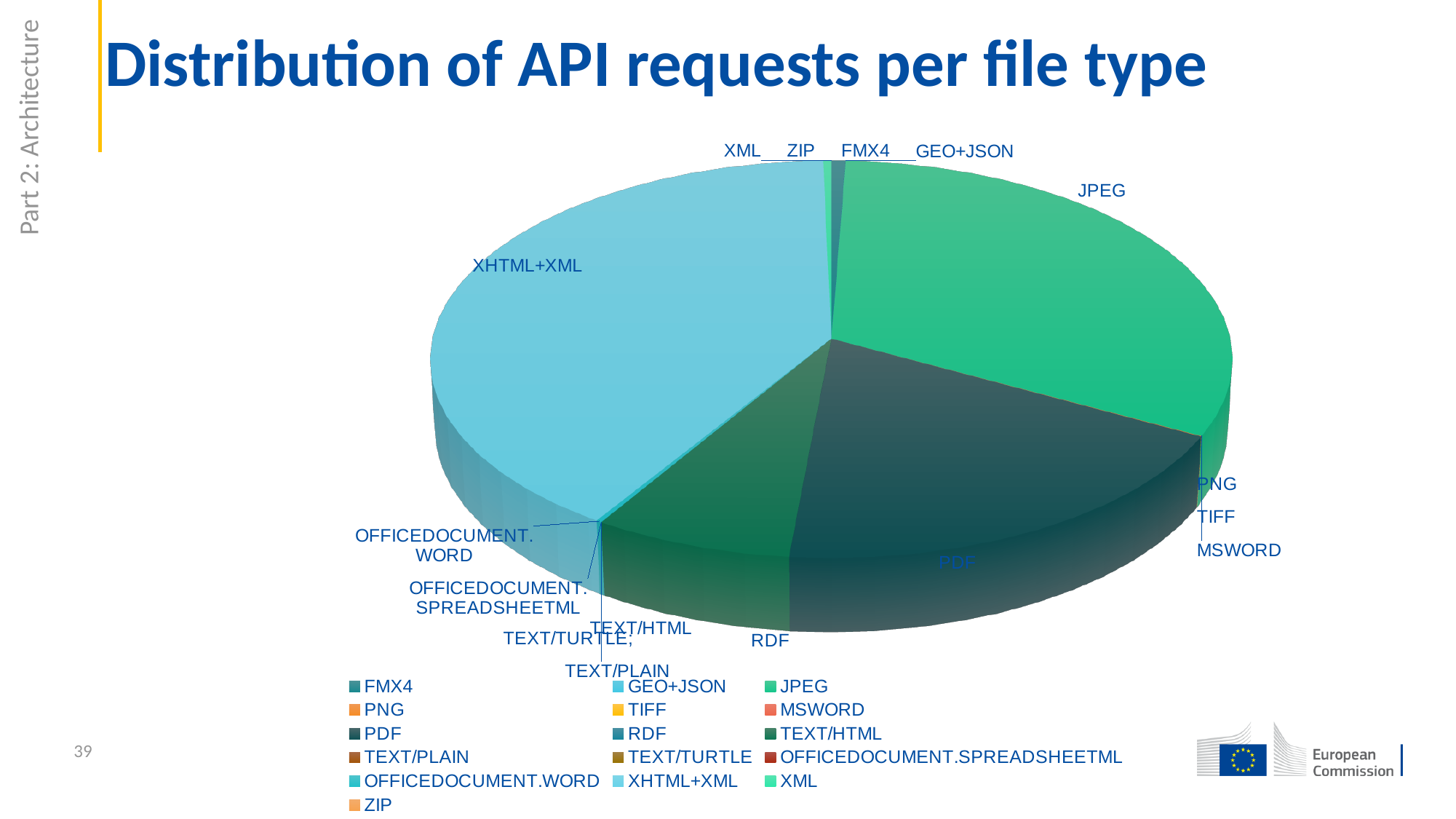
What kind of chart is shown on the slide? Pie chart Which slice is larger, XHTML+XML or JPEG? XHTML+XML How many file types are listed in the chart's legend? 16 What is the title of the chart? Distribution of API requests per file type Which file type has the largest slice of the pie? XHTML+XML Which slice is larger, XHTML+XML or PDF? XHTML+XML Which slice is larger, PDF or RDF? PDF What colour is the XHTML+XML slice? Light blue